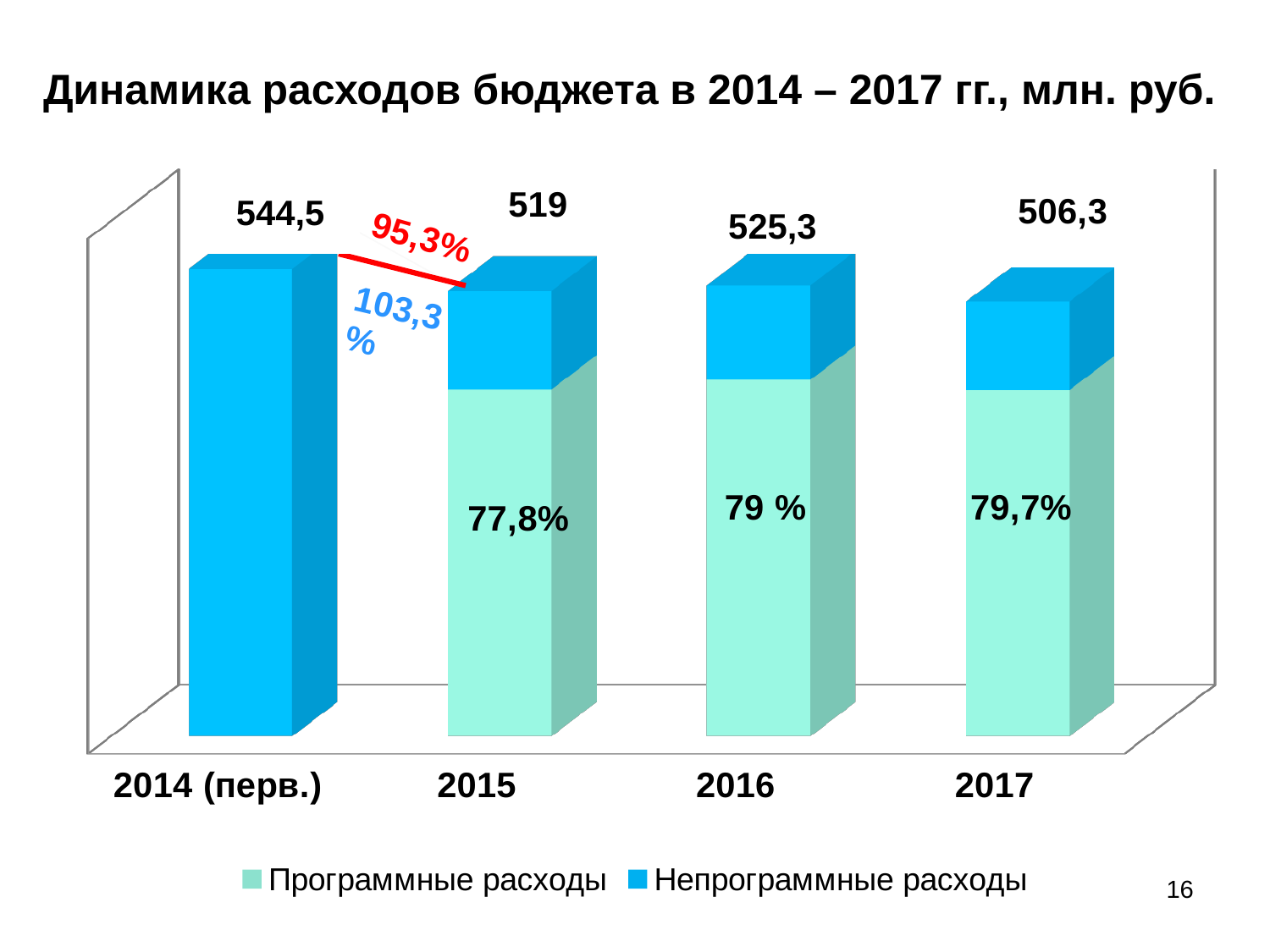
What share of expenditures is labelled as Программные расходы in 2016? 79 % What share of expenditures is labelled as Программные расходы in 2017? 79,7% What is the difference between the total expenditure in 2014 (перв.) and in 2017? 38,2 How many years are shown on the x axis? 4 What kind of chart is shown on the slide? Stacked bar chart What is the total budget expenditure shown for 2015? 519 Which year has the lowest total budget expenditure? 2017 What is the total budget expenditure shown for 2017? 506,3 How many series does the legend list? 2 Which is larger, the total expenditure in 2015 or in 2016? 2016 Which year has the highest total budget expenditure? 2014 (перв.) What is the total budget expenditure shown for 2014 (перв.)? 544,5